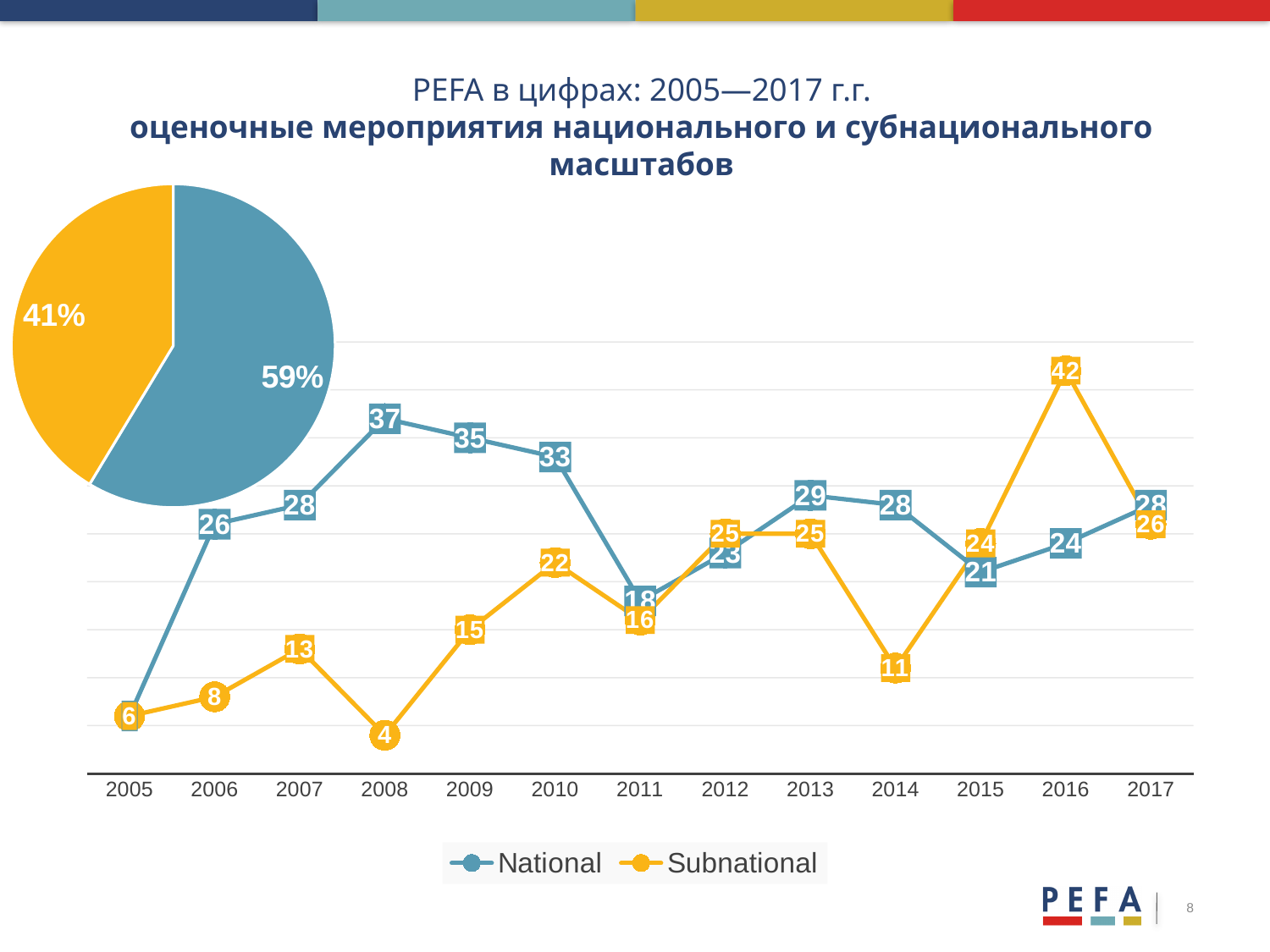
In the line chart, which year has the lowest Subnational value? 2008 In the line chart, what is the National value for 2008? 37 In the line chart, what is the Subnational value for 2014? 11 What kind of chart is the chart on the right side of the slide? line chart In the line chart, does the National value rise or fall from 2008 to 2011? fall In the line chart, which series has the larger value in 2016, National or Subnational? Subnational How many series does the legend of the line chart list? 2 In the pie chart, what share does the blue slice show? 59% In the line chart, what is the Subnational value for 2016? 42 In the line chart, which year has the highest National value? 2008 In the line chart, what is the difference between the National and Subnational values in 2008? 33 How many years are shown on the x axis of the line chart? 13